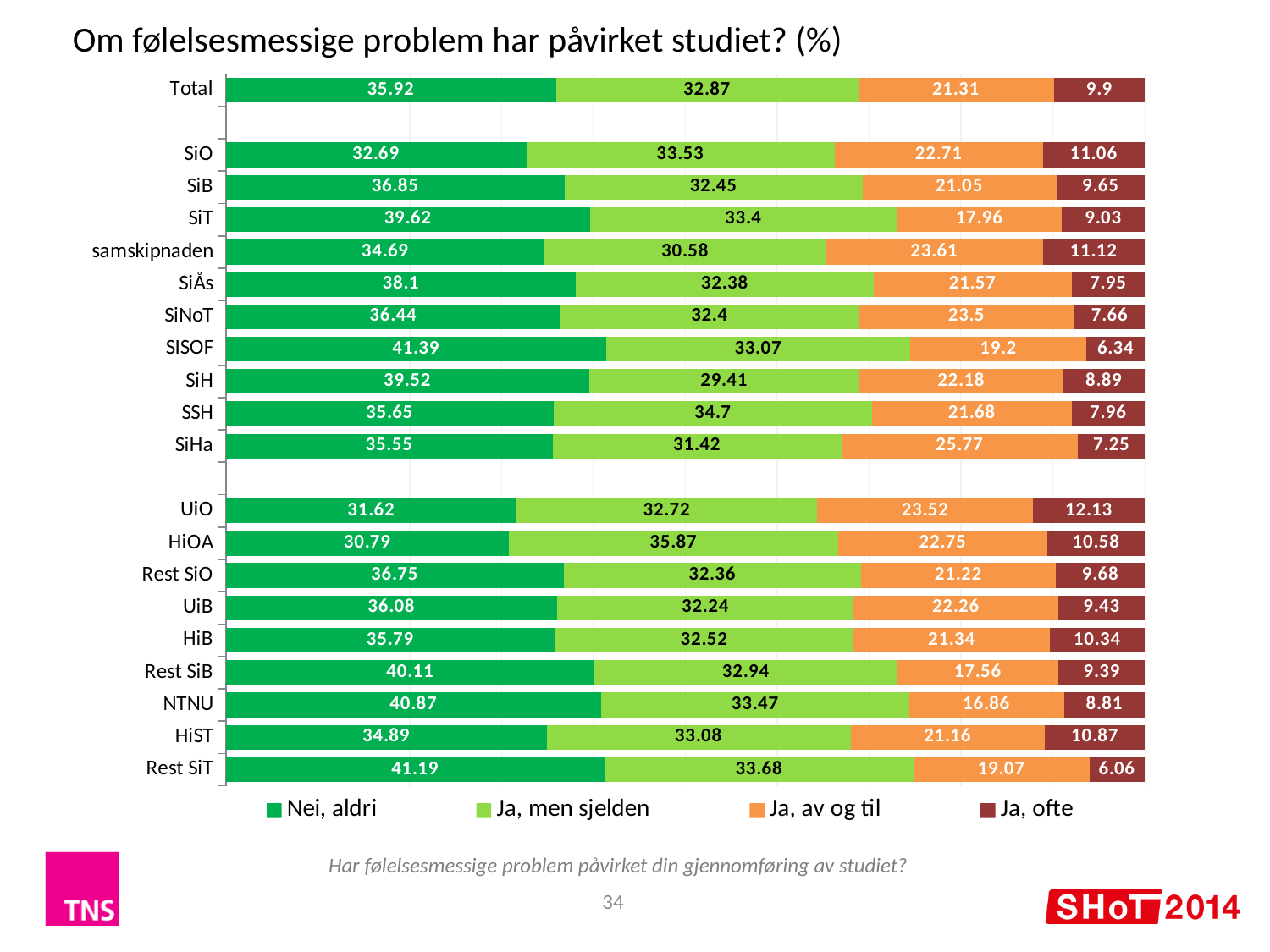
What is the title of the chart? Om følelsesmessige problem har påvirket studiet? (%) What is the difference between "Nei, aldri" and "Ja, ofte" for Total? 26.02 Which category has the lowest value for "Ja, ofte"? Rest SiT Which category has the highest value for "Ja, ofte"? UiO How many series does the legend list? 4 What is the value of "Ja, ofte" for UiO? 12.13 What kind of chart is shown on the slide? Stacked bar chart Which category has the lowest value for "Ja, av og til"? NTNU What is the value of "Ja, av og til" for SiHa? 25.77 How many categories are shown on the y axis? 20 Which has the larger value for "Ja, men sjelden", HiOA or UiO? HiOA What is the value of "Nei, aldri" for NTNU? 40.87